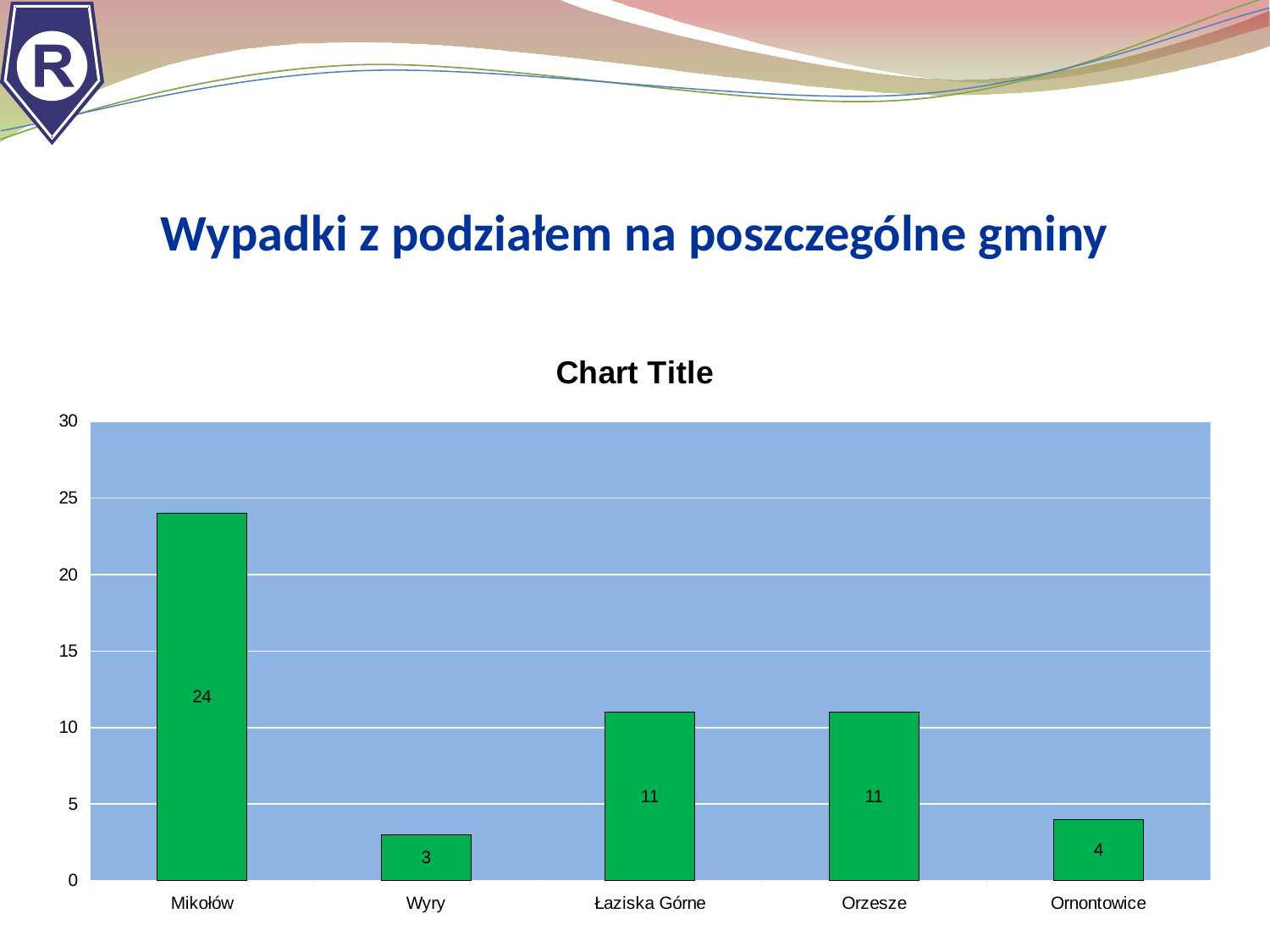
What is the difference between the values for Mikołów and Orzesze? 13 Is the value for Mikołów greater or less than 20? greater Which category has the lowest value? Wyry What is the title printed above the chart? Chart Title How many categories are shown on the x axis? 5 What is the value for Wyry? 3 Which category has the highest value? Mikołów Which is larger, the value for Ornontowice or the value for Wyry? Ornontowice What is the value for Mikołów? 24 What is the value for Ornontowice? 4 What kind of chart is shown on the slide? bar chart What is the value for Łaziska Górne? 11